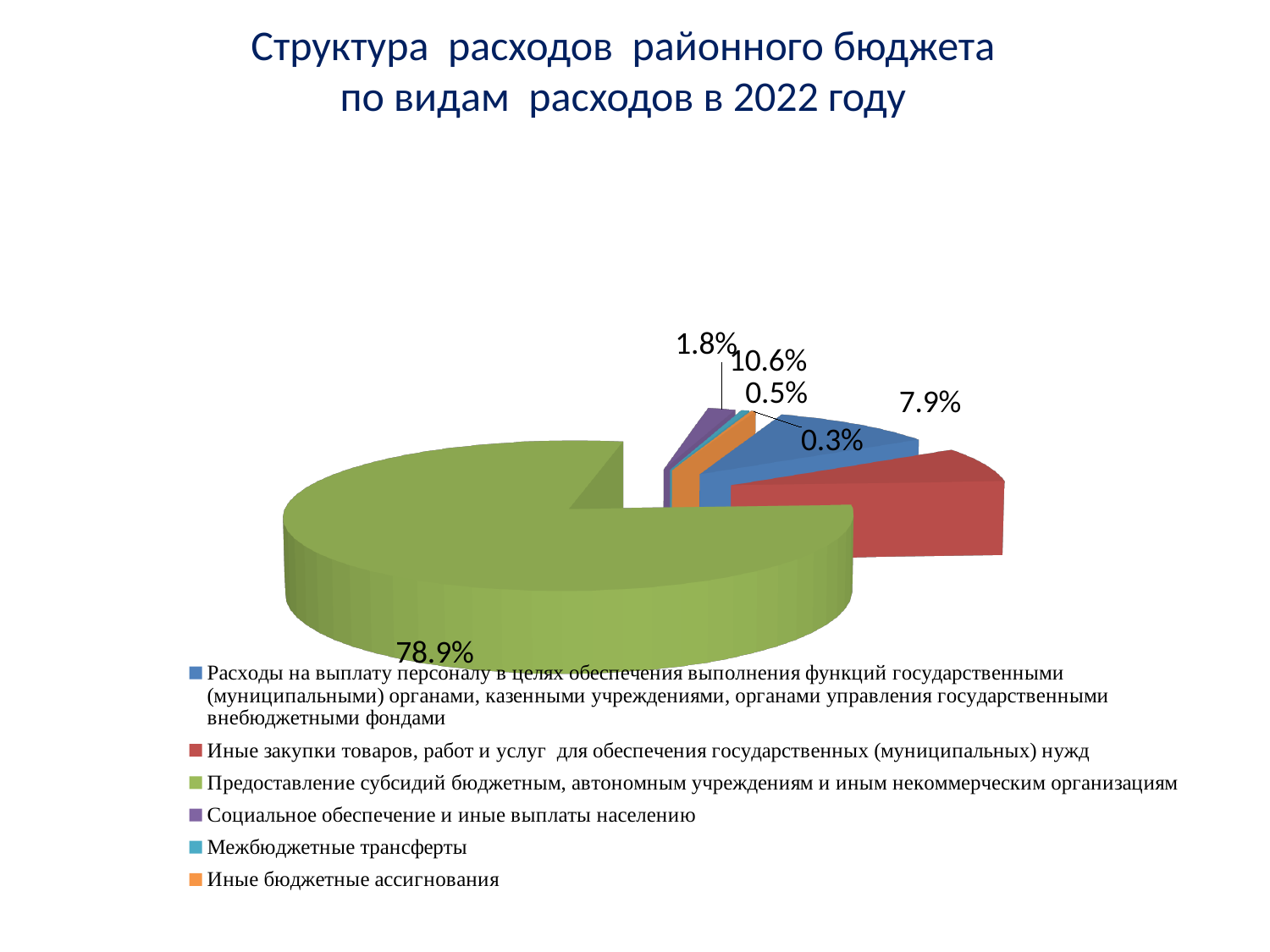
What is the title of the chart on the slide? Структура расходов районного бюджета по видам расходов в 2022 году What share is labelled for 'Социальное обеспечение и иные выплаты населению'? 1.8% How many categories does the legend of the pie chart list? 6 What share is labelled for 'Расходы на выплату персоналу в целях обеспечения выполнения функций государственными (муниципальными) органами, казенными учреждениями, органами управления государственными внебюджетными фондами'? 10.6% What colour is the slice for 'Предоставление субсидий бюджетным, автономным учреждениям и иным некоммерческим организациям'? green Which category has the largest share of the pie? Предоставление субсидий бюджетным, автономным учреждениям и иным некоммерческим организациям What share is labelled for 'Иные закупки товаров, работ и услуг для обеспечения государственных (муниципальных) нужд'? 7.9% What kind of chart is shown on the slide? pie chart What is the smallest percentage label shown on the pie chart? 0.3% Which is larger: the share for 'Предоставление субсидий бюджетным, автономным учреждениям и иным некоммерческим организациям' or the share for 'Иные закупки товаров, работ и услуг для обеспечения государственных (муниципальных) нужд'? Предоставление субсидий бюджетным, автономным учреждениям и иным некоммерческим организациям What is the largest percentage label shown on the pie chart? 78.9%